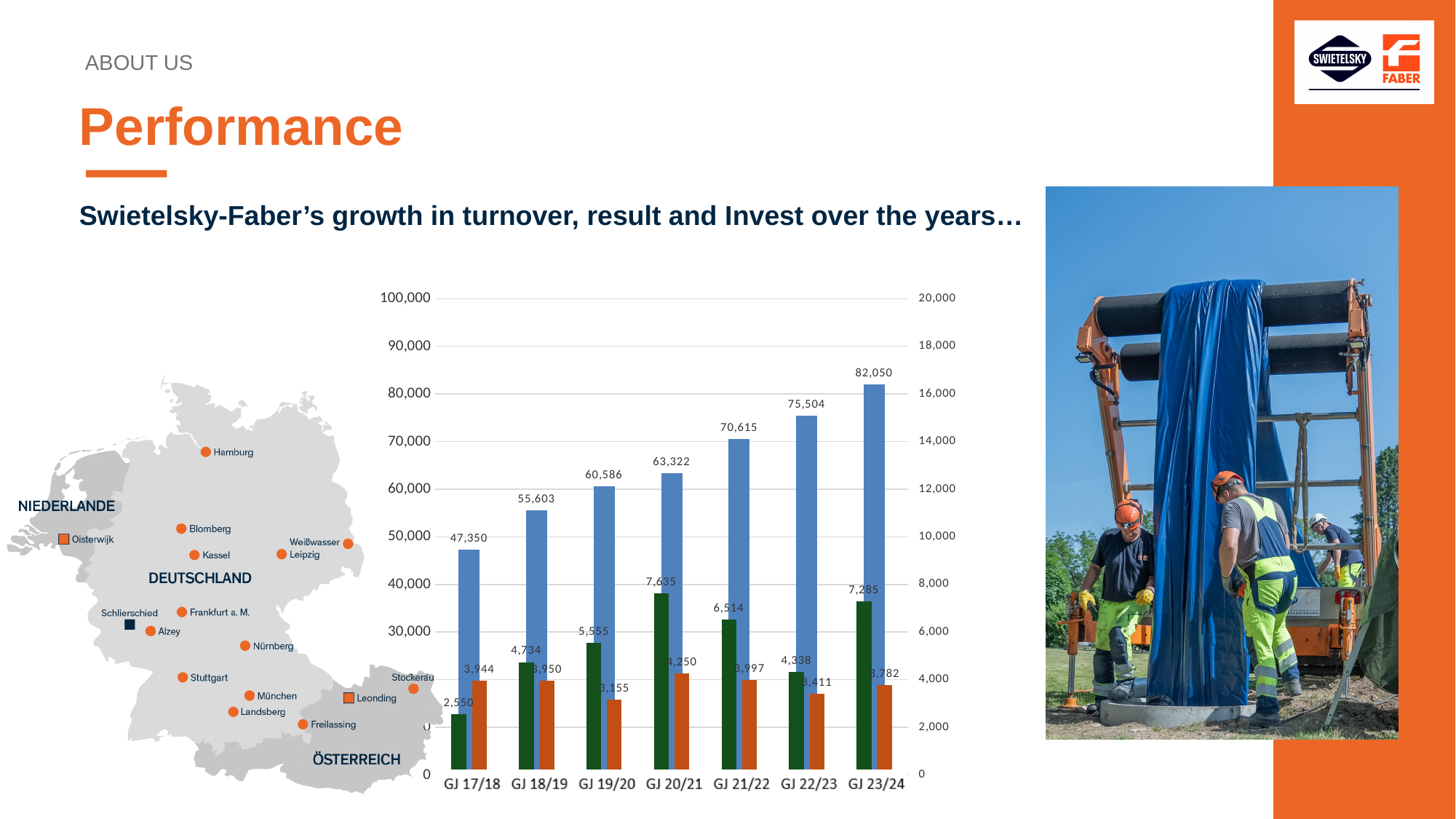
Which fiscal year has the lowest green bar? GJ 17/18 What is the difference between the blue bar values for GJ 23/24 and GJ 22/23? 6,546 Is the blue bar for GJ 19/20 greater or less than 60,000 on the left axis? greater What is the value of the blue bar for GJ 17/18? 47,350 How many fiscal years are shown on the x axis? 7 What is the value of the blue bar for GJ 23/24? 82,050 Do the blue bar values rise or fall from GJ 17/18 to GJ 23/24? rise Which is larger, the green bar for GJ 20/21 or the green bar for GJ 21/22? GJ 20/21 Which fiscal year has the highest blue bar? GJ 23/24 What kind of chart is shown on the slide? bar chart What is the value of the green bar for GJ 20/21? 7,635 What is the value of the orange bar for GJ 17/18? 3,944